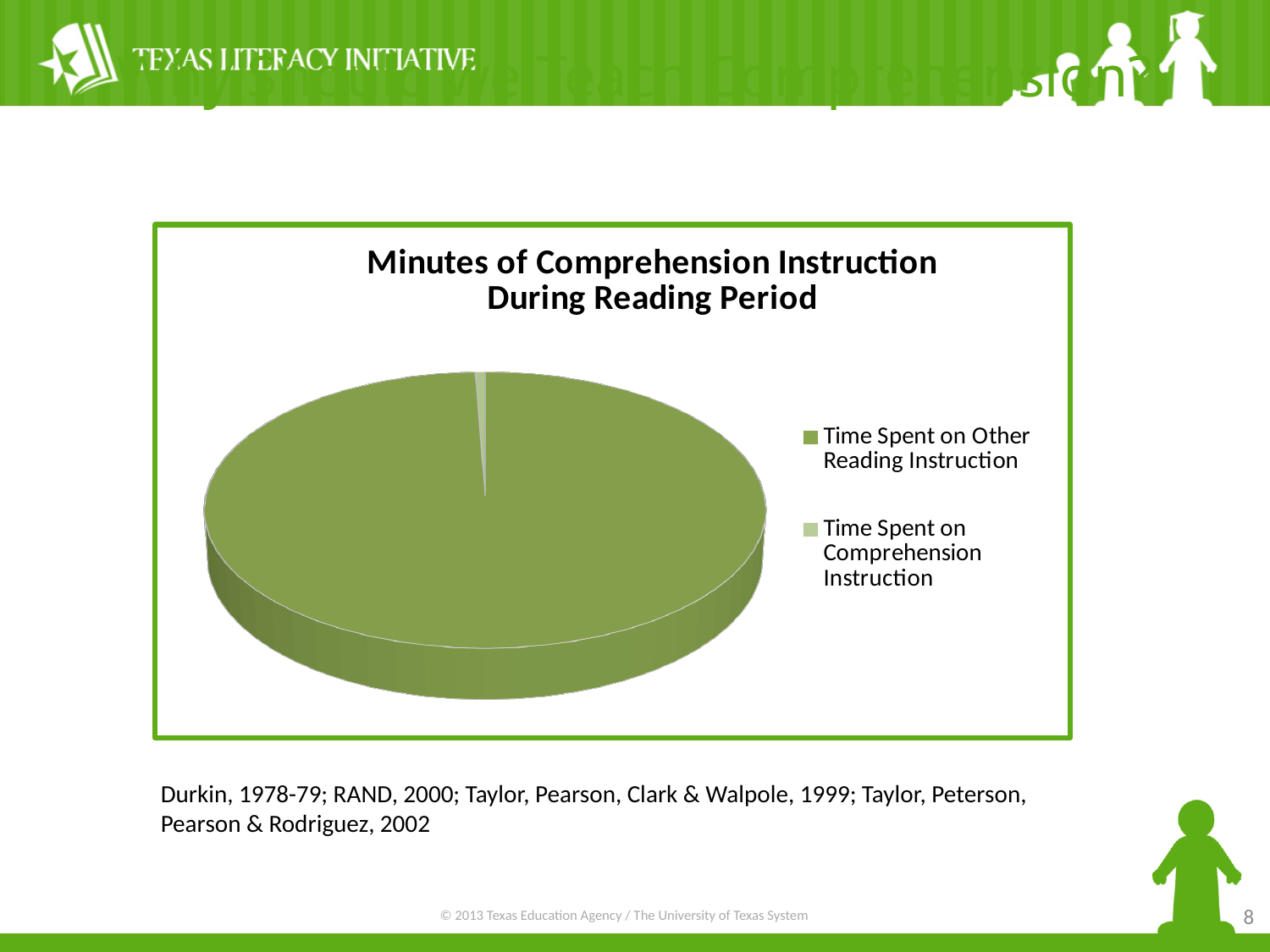
Which slice of the pie chart is the largest? Time Spent on Other Reading Instruction How many entries does the chart legend list? 2 How many slices does the pie chart have? 2 Which slice of the pie chart is the smallest? Time Spent on Comprehension Instruction Which is larger: the slice for Time Spent on Other Reading Instruction or the slice for Time Spent on Comprehension Instruction? Time Spent on Other Reading Instruction What is the title of the chart? Minutes of Comprehension Instruction During Reading Period Which legend entry is shown in the lighter green colour? Time Spent on Comprehension Instruction What kind of chart is shown on the slide? Pie chart